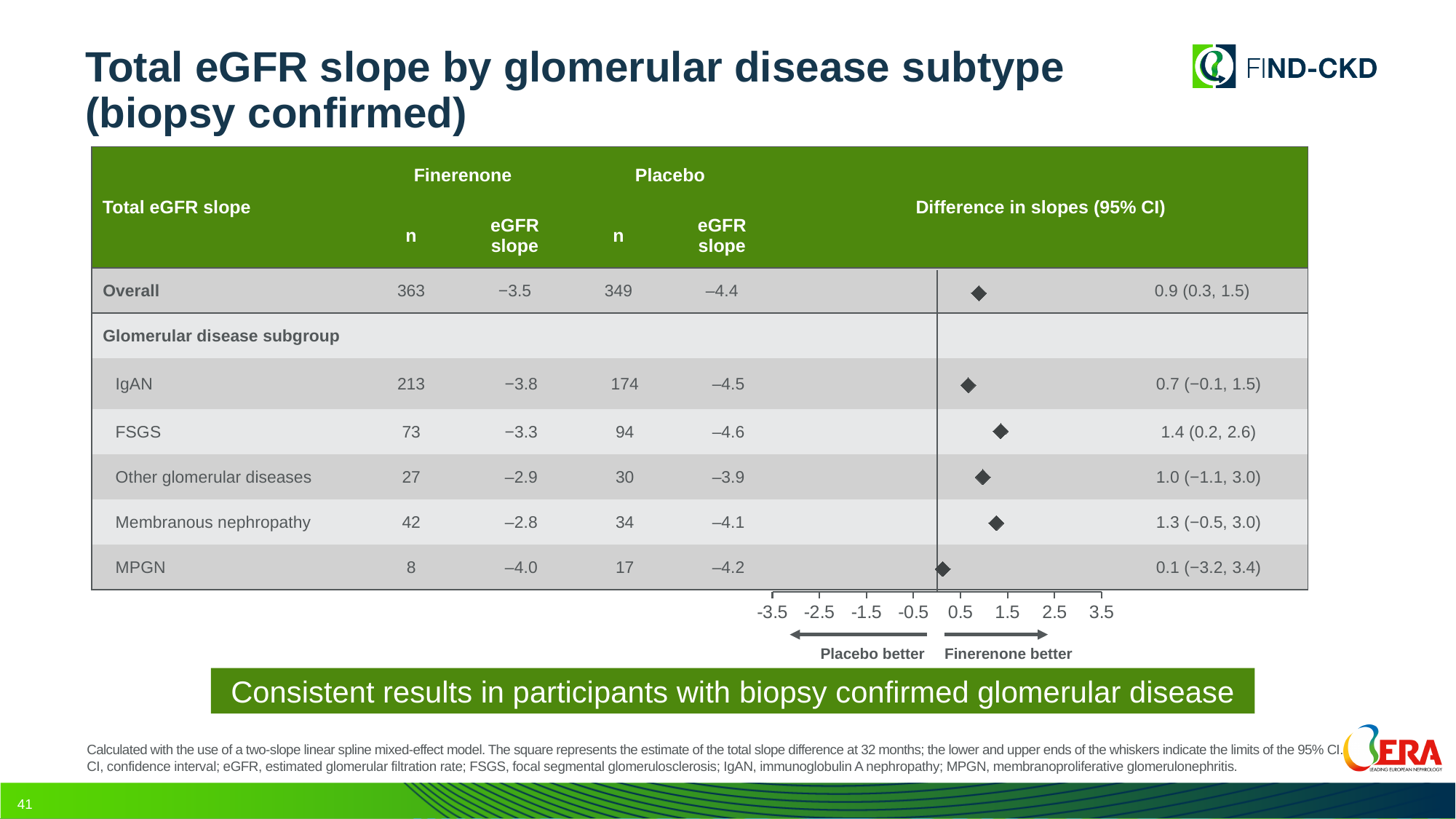
What does the right-pointing arrow below the axis indicate? Finerenone better Is the point estimate for MPGN greater or less than 0.5? less Which subgroup has the highest point estimate for the difference in slopes? FSGS What is the lowest tick value shown on the x axis of the forest plot? -3.5 What is the difference in slopes (95% CI) for FSGS? 1.4 (0.2, 2.6) How many groups (including Overall) are plotted in the forest plot? 6 Which subgroup has the lowest point estimate for the difference in slopes? MPGN What is the difference in slopes (95% CI) for MPGN? 0.1 (−3.2, 3.4) What is the point estimate of the difference in slopes for the Overall group? 0.9 Which has a larger point estimate for the difference in slopes, Membranous nephropathy or Other glomerular diseases? Membranous nephropathy What is the difference between the point estimates for FSGS and IgAN? 0.7 What kind of chart is used to show the difference in slopes? Forest plot